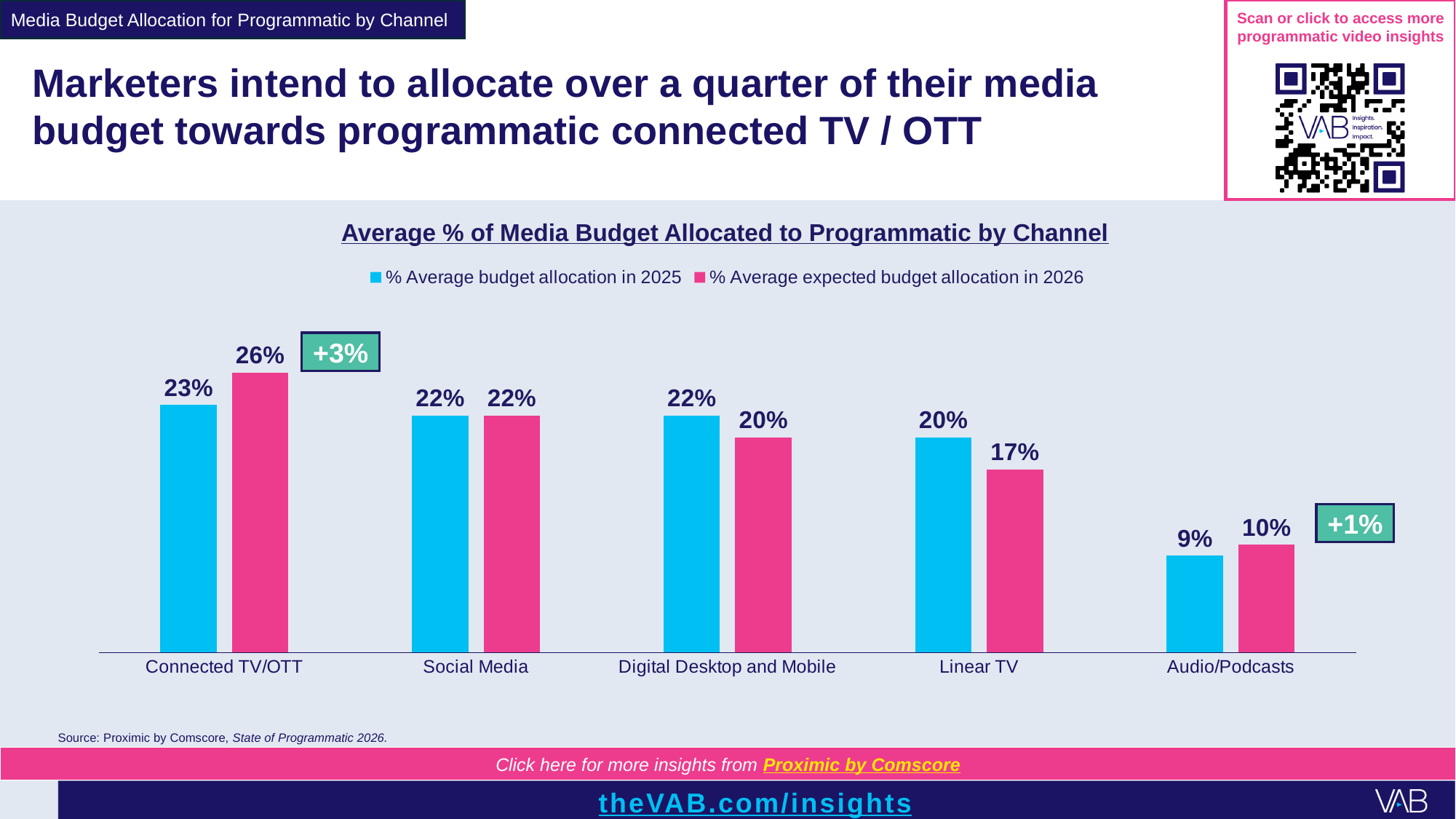
What is the title of the chart? Average % of Media Budget Allocated to Programmatic by Channel What is the difference between the 2025 and 2026 expected budget allocation for Linear TV? 3% What is the % average expected budget allocation in 2026 for Linear TV? 17% What is the difference between the 2026 expected and 2025 budget allocation for Connected TV/OTT? 3% Which is larger for Digital Desktop and Mobile: the 2025 allocation or the 2026 expected allocation? 2025 allocation What is the % average expected budget allocation in 2026 for Audio/Podcasts? 10% Which channel has the lowest % average budget allocation in 2025? Audio/Podcasts What type of chart is used to show the budget allocation by channel? Bar chart Which channel has the highest % average expected budget allocation in 2026? Connected TV/OTT How many series does the chart legend list? 2 What is the % average budget allocation in 2025 for Connected TV/OTT? 23% How many channels are shown on the x axis of the chart? 5